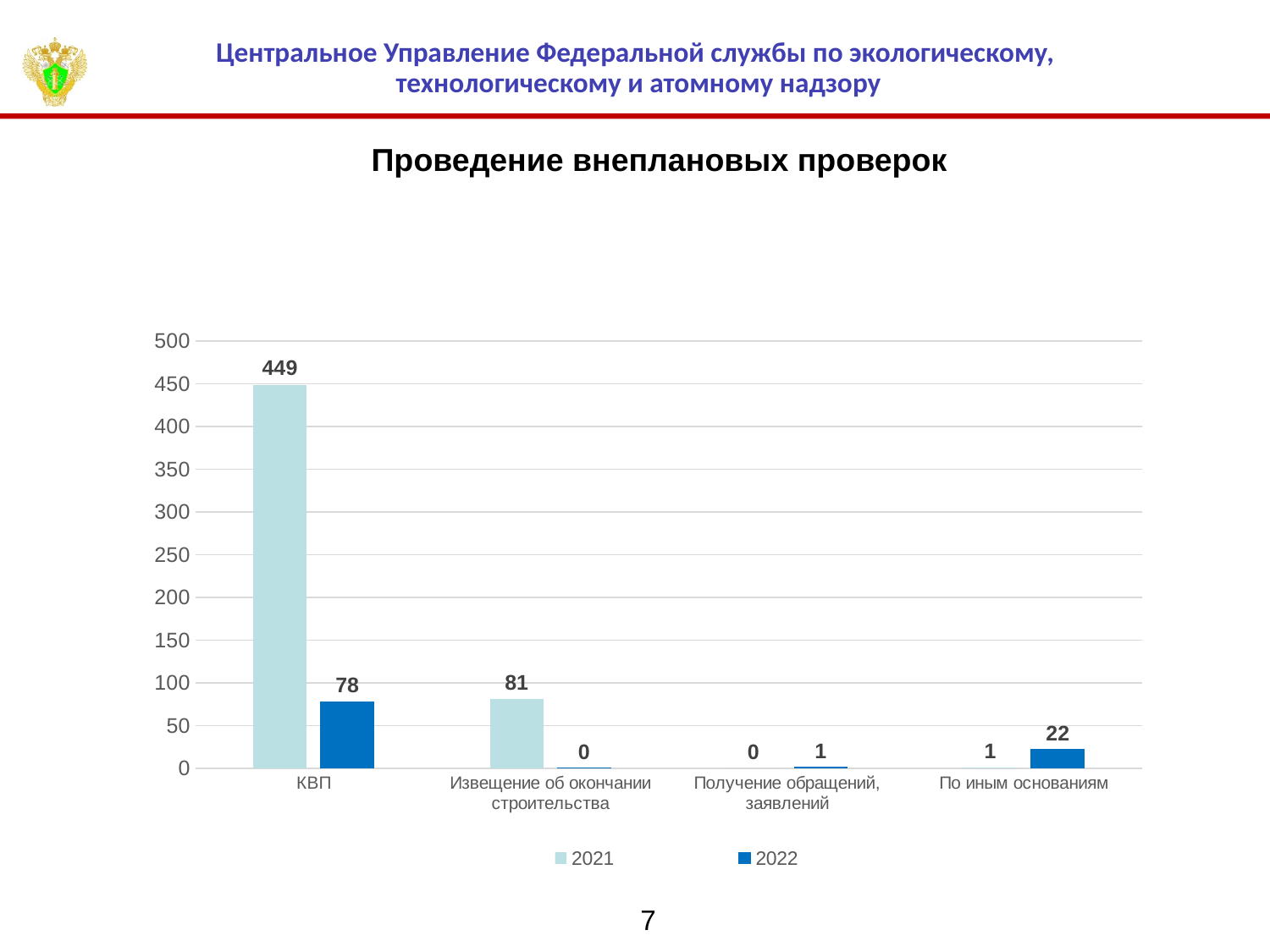
What is the value for Извещение об окончании строительства in 2021? 81 Which category has the highest value in 2021? КВП What is the value for По иным основаниям in 2022? 22 What is the title of the chart? Проведение внеплановых проверок Which category has the lowest value in 2022? Извещение об окончании строительства Which is larger for По иным основаниям: the 2021 value or the 2022 value? 2022 What is the difference between the 2021 and 2022 values for КВП? 371 How many series does the legend list? 2 What is the value for КВП in 2021? 449 What is the value for КВП in 2022? 78 What kind of chart is shown on the slide? Bar chart How many categories are shown on the x axis? 4